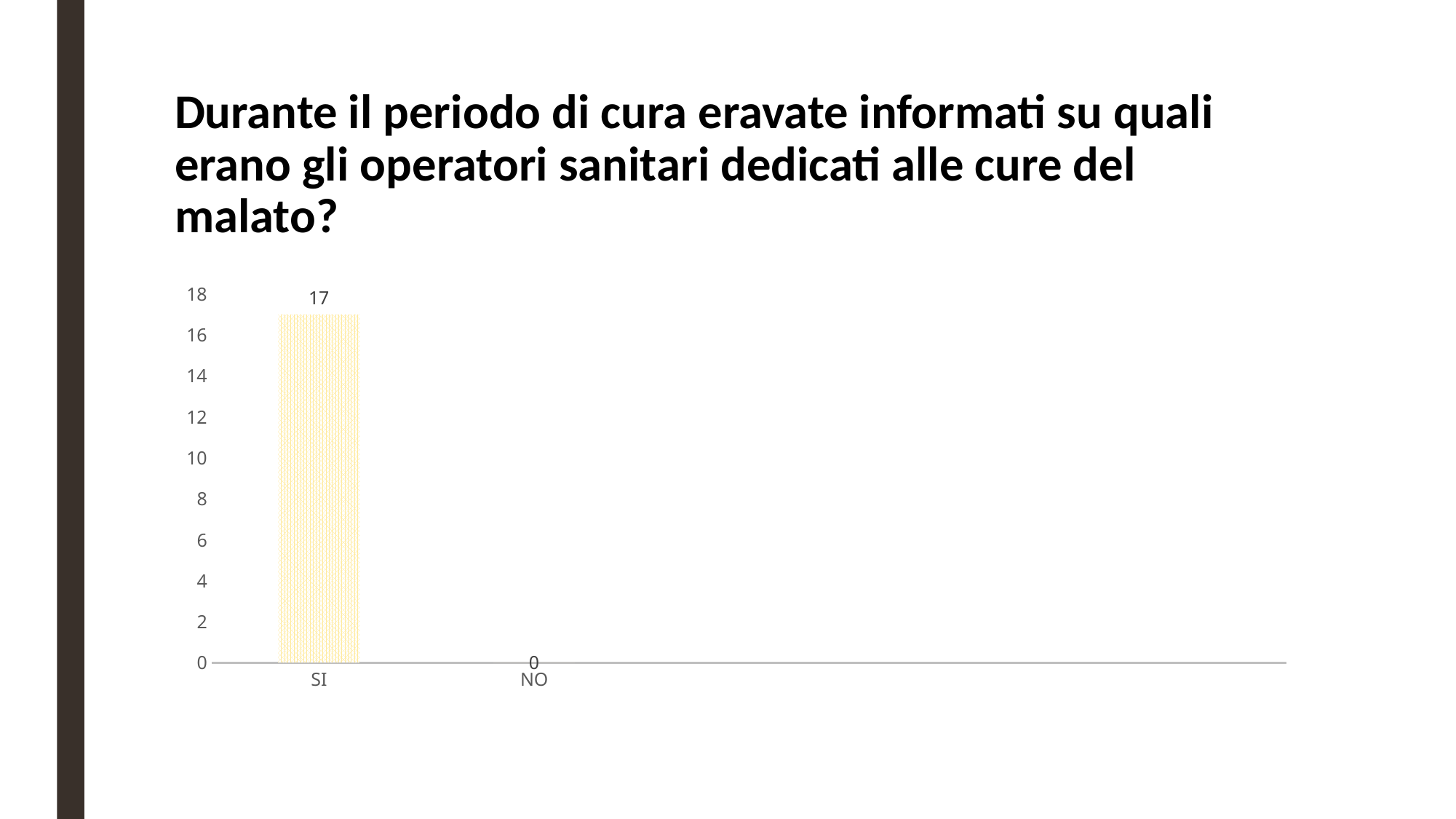
Is the value for SI greater or less than 10? greater Which is larger, the value for SI or the value for NO? SI What is the value for SI? 17 Which category has the highest value? SI What kind of chart is shown on the slide? bar chart What is the highest value shown on the y axis? 18 How many categories are shown on the x axis? 2 Which category has the lowest value? NO What is the title of the slide above the chart? Durante il periodo di cura eravate informati su quali erano gli operatori sanitari dedicati alle cure del malato? What is the difference between the values for SI and NO? 17 What is the total of the values for SI and NO? 17 What is the value for NO? 0